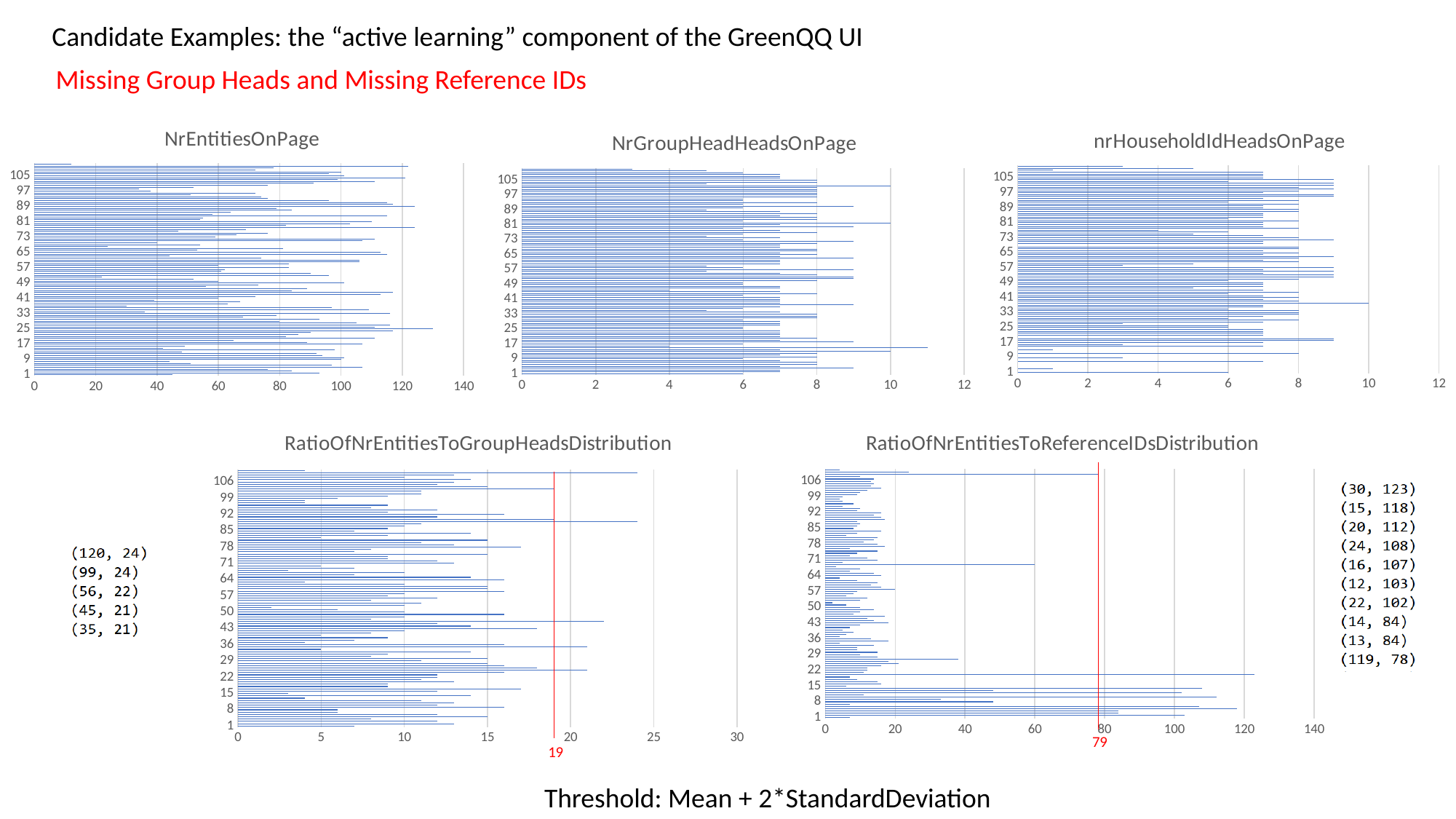
In the RatioOfNrEntitiesToReferenceIDsDistribution chart, is the value of the longest bar greater or less than 100? greater In the RatioOfNrEntitiesToGroupHeadsDistribution chart, what threshold value is marked in red below the x axis? 19 Which chart on the slide has an x axis that extends to 30? RatioOfNrEntitiesToGroupHeadsDistribution In the NrEntitiesOnPage chart, is the value of the longest bar greater or less than 120? greater In the RatioOfNrEntitiesToReferenceIDsDistribution chart, what threshold value is marked in red below the x axis? 79 In the nrHouseholdIdHeadsOnPage chart, is the value of the longest bar greater or less than 8? greater According to the text at the bottom of the slide, how is the threshold computed? Mean + 2*StandardDeviation What kind of chart is NrEntitiesOnPage? bar chart How many charts are shown on the slide? 5